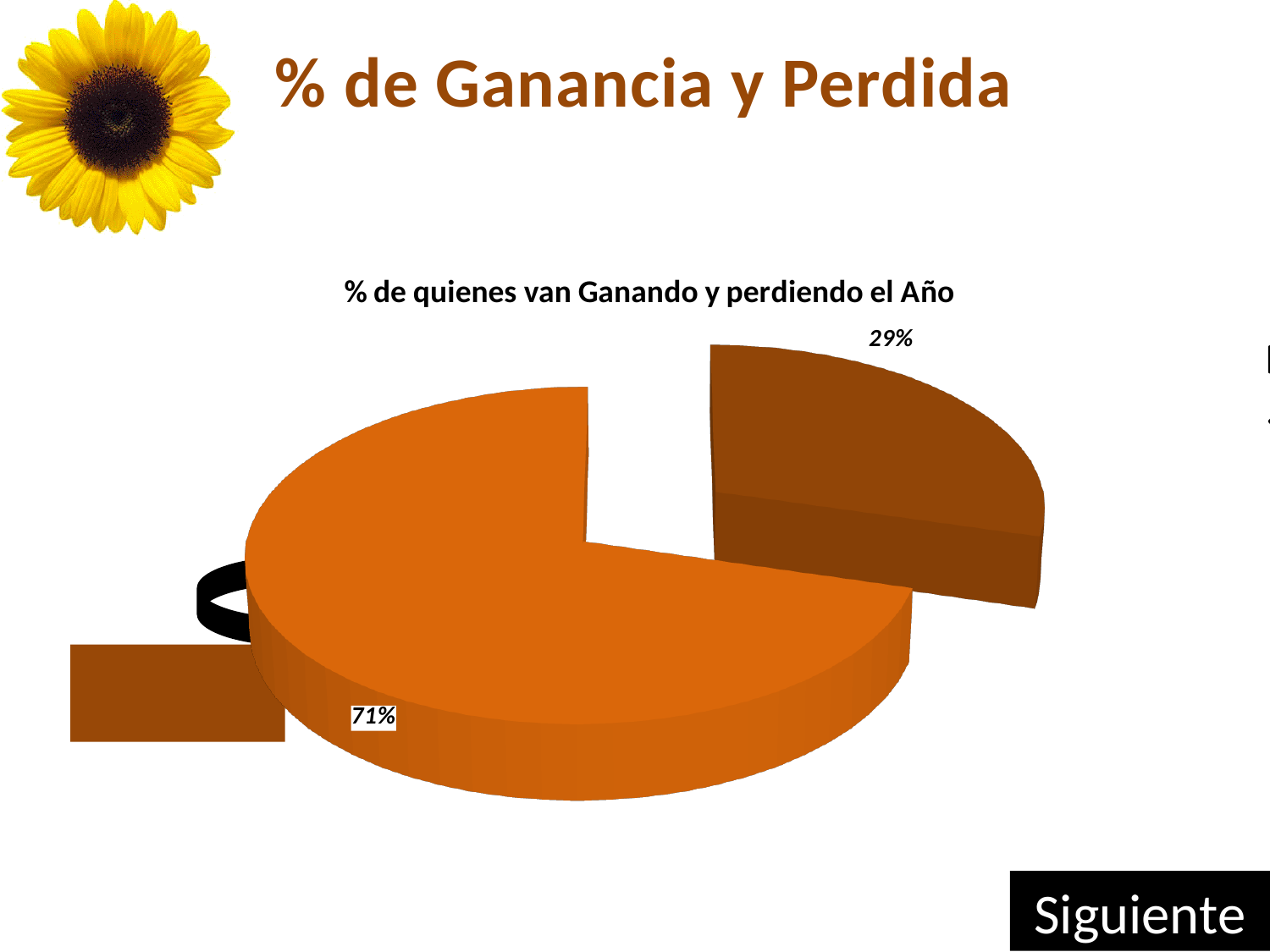
Which slice is larger, the one labelled 71% or the one labelled 29%? 71% What is the difference in percentage points between the two slices of the pie chart? 42 What is the value of the smallest slice of the pie chart? 29% What is the value of the largest slice of the pie chart? 71% What kind of chart is shown on the slide? pie chart Is the value of the largest slice greater or less than 50%? greater How many slices does the pie chart have? 2 Do the two slices of the pie chart add up to 100%? yes What is the title of the chart? % de quienes van Ganando y perdiendo el Año What percentage is shown on the slice that is pulled out from the rest of the pie? 29% Is the value of the smallest slice greater or less than 50%? less